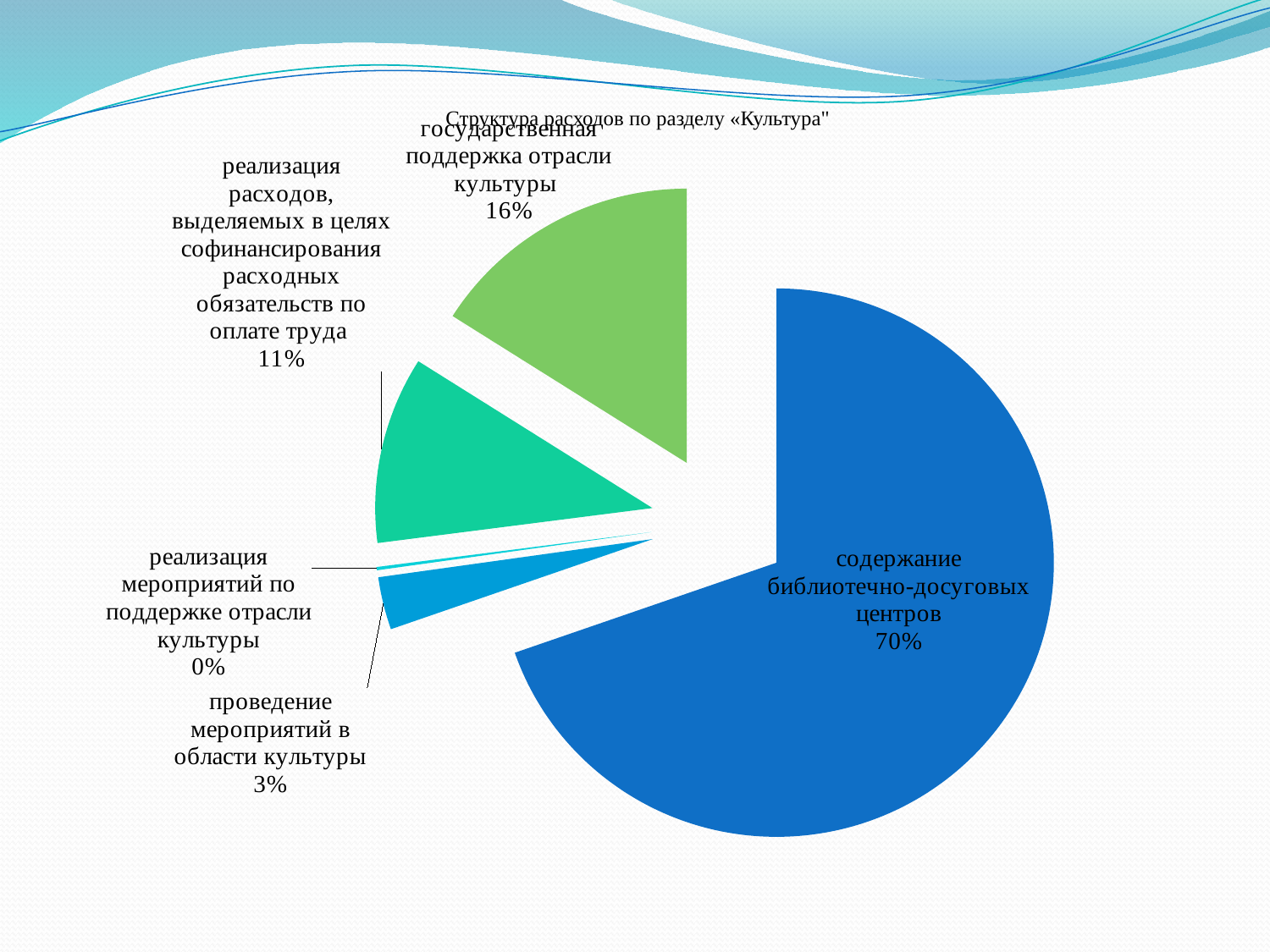
Which category has the smallest share of expenses? реализация мероприятий по поддержке отрасли культуры Which category has the largest share of expenses? содержание библиотечно-досуговых центров What share of expenses goes to "содержание библиотечно-досуговых центров"? 70% Which is larger: the share for "государственная поддержка отрасли культуры" or the share for "проведение мероприятий в области культуры"? государственная поддержка отрасли культуры What share of expenses goes to "проведение мероприятий в области культуры"? 3% What share of expenses goes to "государственная поддержка отрасли культуры"? 16% What is the difference in percentage points between "содержание библиотечно-досуговых центров" and "государственная поддержка отрасли культуры"? 54% How many slices does the pie chart have? 5 What kind of chart is shown on the slide? pie chart What is the title of the chart? Структура расходов по разделу «Культура"